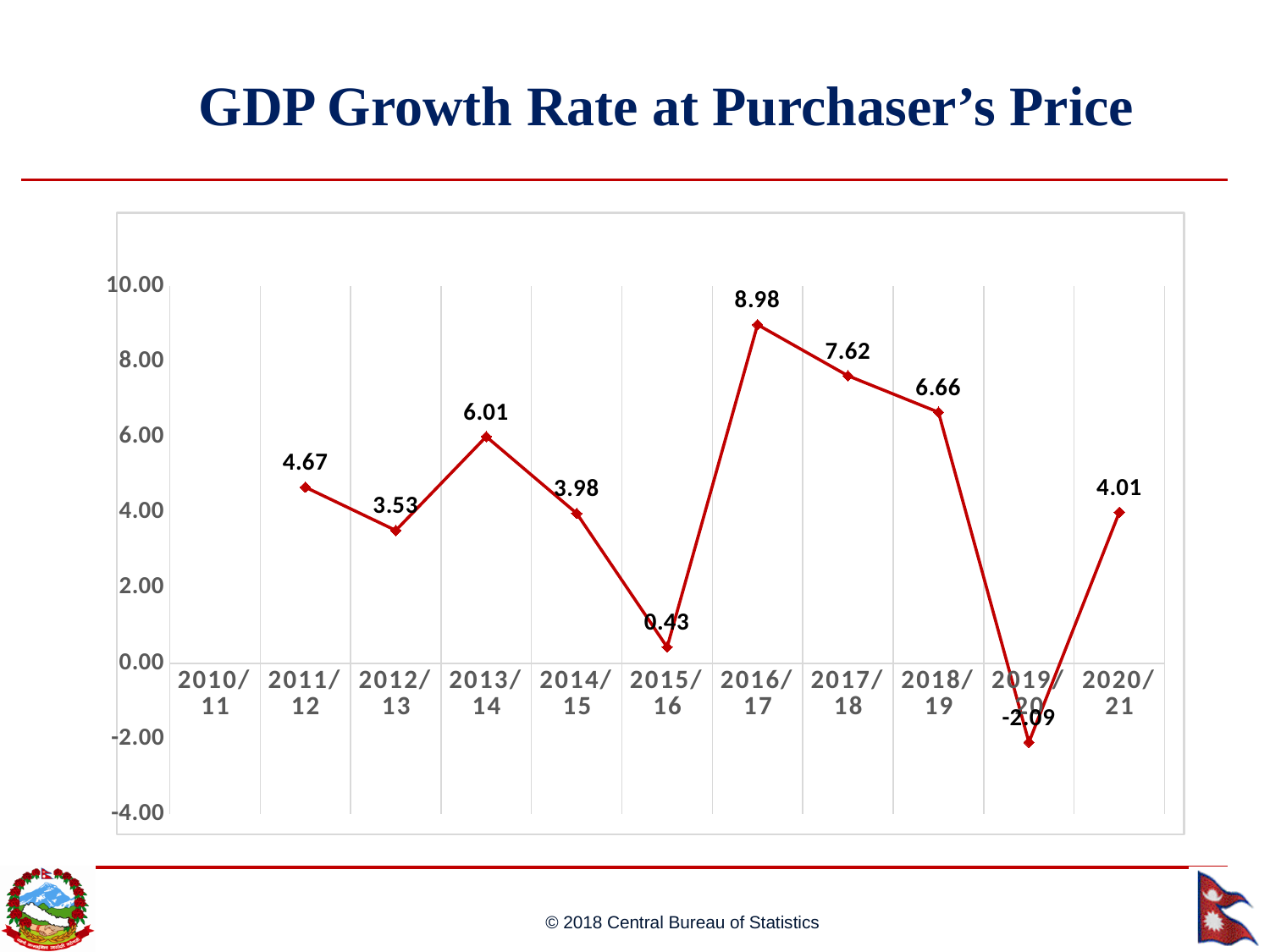
What is the GDP growth rate for 2020/21? 4.01 What is the GDP growth rate for 2019/20? -2.09 What is the GDP growth rate for 2016/17? 8.98 What is the GDP growth rate for 2013/14? 6.01 Which year has the lowest GDP growth rate? 2019/20 Which is larger, the GDP growth rate for 2011/12 or for 2014/15? 2011/12 What is the difference between the GDP growth rates for 2016/17 and 2017/18? 1.36 Does the GDP growth rate rise or fall from 2016/17 to 2018/19? fall What is the difference between the GDP growth rates for 2013/14 and 2012/13? 2.48 Which year has the highest GDP growth rate? 2016/17 How many year categories are labelled on the x axis? 11 What kind of chart is shown on the slide? line chart